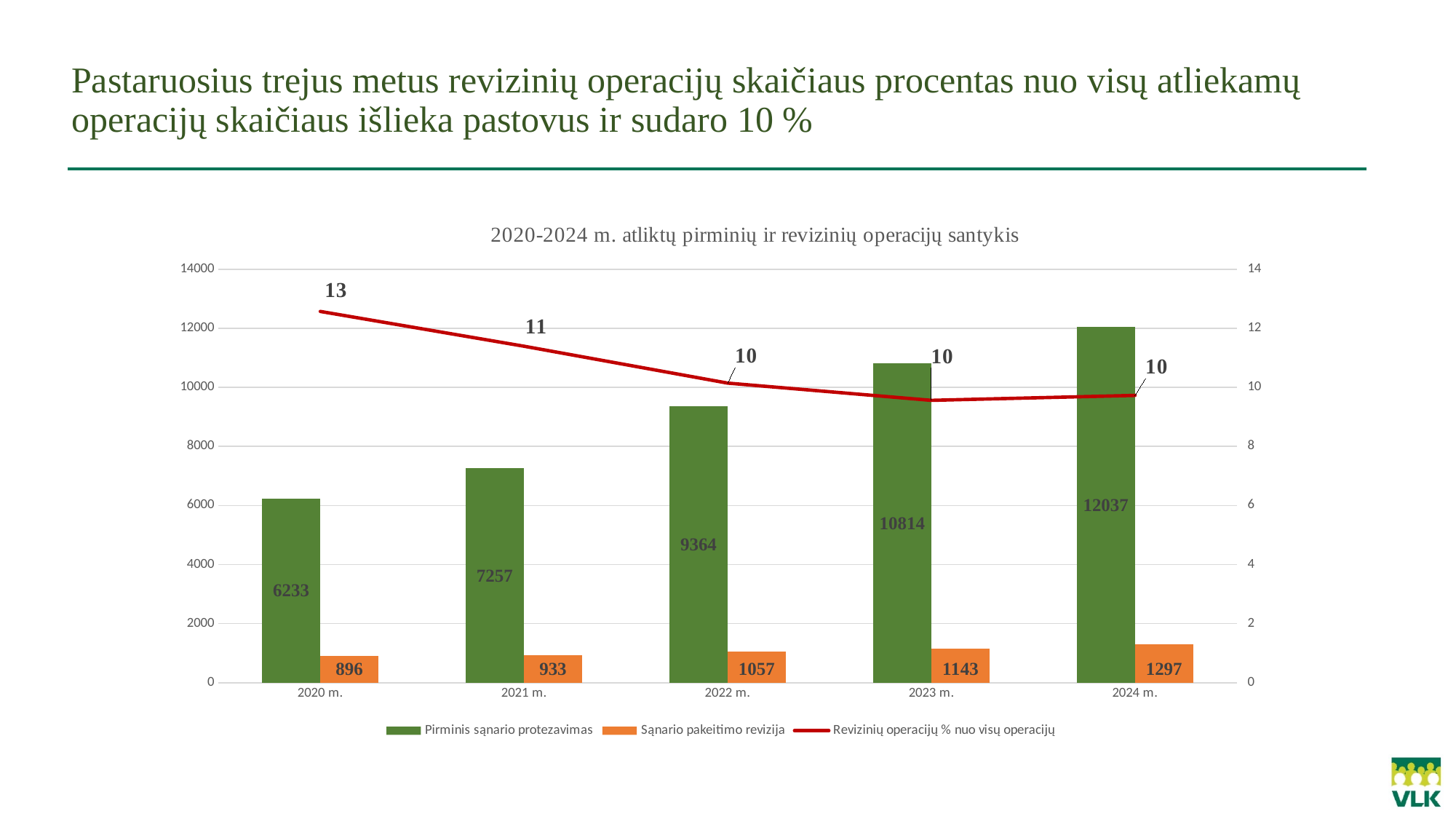
What is the difference between Pirminis sąnario protezavimas in 2023 m. and 2022 m.? 1450 Which year has the highest value for Pirminis sąnario protezavimas? 2024 m. Which year has the lowest value for Sąnario pakeitimo revizija? 2020 m. What is the value for Sąnario pakeitimo revizija in 2020 m.? 896 Which is larger: Sąnario pakeitimo revizija in 2022 m. or in 2021 m.? 2022 m. What is the value for Pirminis sąnario protezavimas in 2024 m.? 12037 What is the value of Revizinių operacijų % nuo visų operacijų in 2021 m.? 11 Does the value for Pirminis sąnario protezavimas rise or fall from 2020 m. to 2024 m.? rise What is the title of the chart? 2020-2024 m. atliktų pirminių ir revizinių operacijų santykis How many years are shown on the x axis? 5 How many series does the legend list? 3 Is the value for Pirminis sąnario protezavimas in 2021 m. greater or less than 8000? less